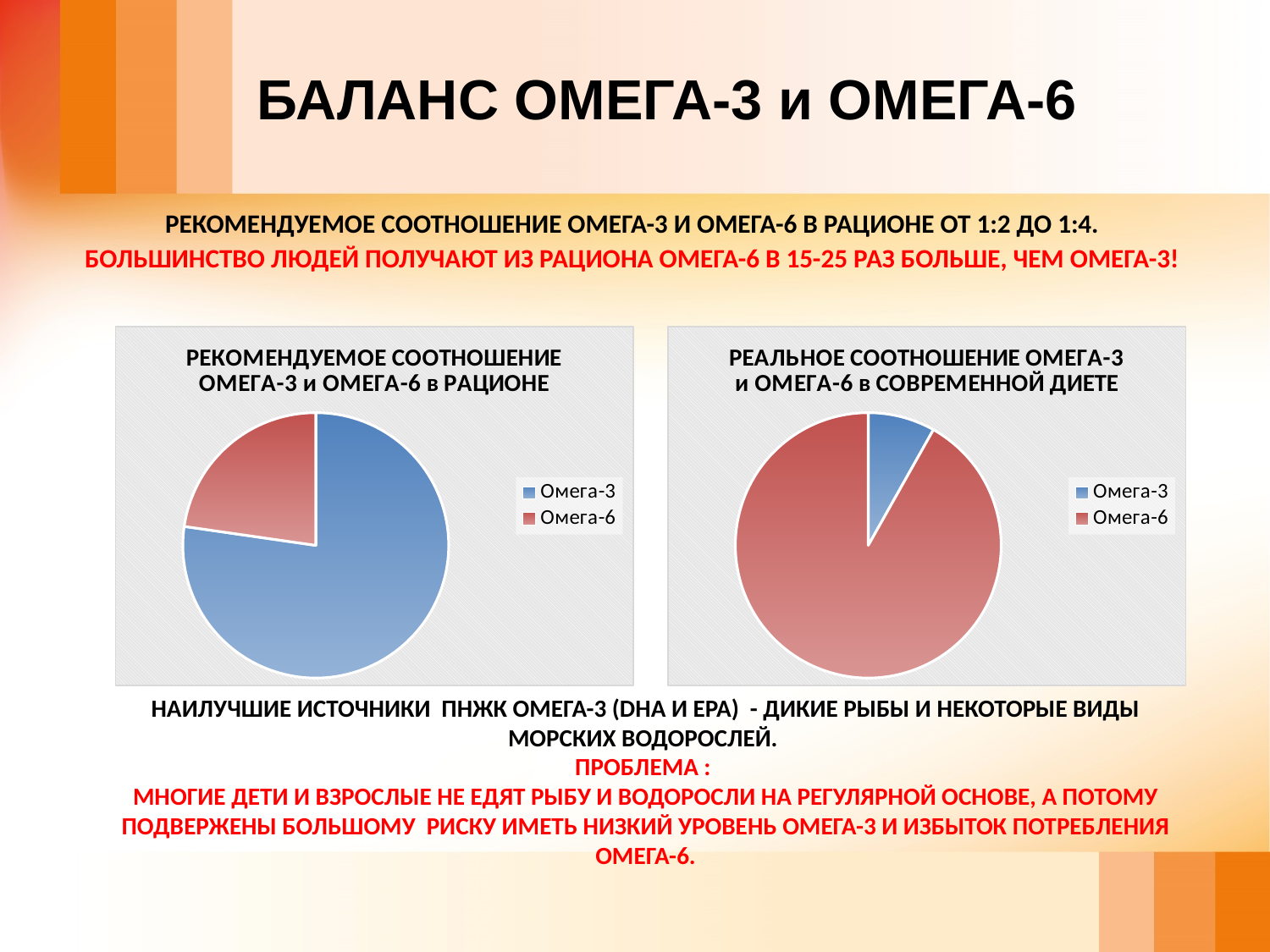
In the right chart (real ratio in the modern diet), what colour is the Омега-6 slice? Red In the right chart (real ratio in the modern diet), which slice is the largest? Омега-6 In the right chart (real ratio in the modern diet), which slice is the smallest? Омега-3 What kind of chart is the left chart titled "РЕКОМЕНДУЕМОЕ СООТНОШЕНИЕ ОМЕГА-3 и ОМЕГА-6 в РАЦИОНЕ"? Pie chart In the right chart (real ratio in the modern diet), which is larger: the Омега-3 slice or the Омега-6 slice? Омега-6 What kind of chart is the right chart titled "РЕАЛЬНОЕ СООТНОШЕНИЕ ОМЕГА-3 и ОМЕГА-6 в СОВРЕМЕННОЙ ДИЕТЕ"? Pie chart What is the title of the left chart? РЕКОМЕНДУЕМОЕ СООТНОШЕНИЕ ОМЕГА-3 и ОМЕГА-6 в РАЦИОНЕ In the left chart (recommended ratio), which is larger: the Омега-3 slice or the Омега-6 slice? Омега-3 In the left chart (recommended ratio), which slice is the largest? Омега-3 How many entries does the legend of the right chart (real ratio in the modern diet) list? 2 How many slices does the left pie chart (recommended ratio) have? 2 In the left chart (recommended ratio), which slice is the smallest? Омега-6